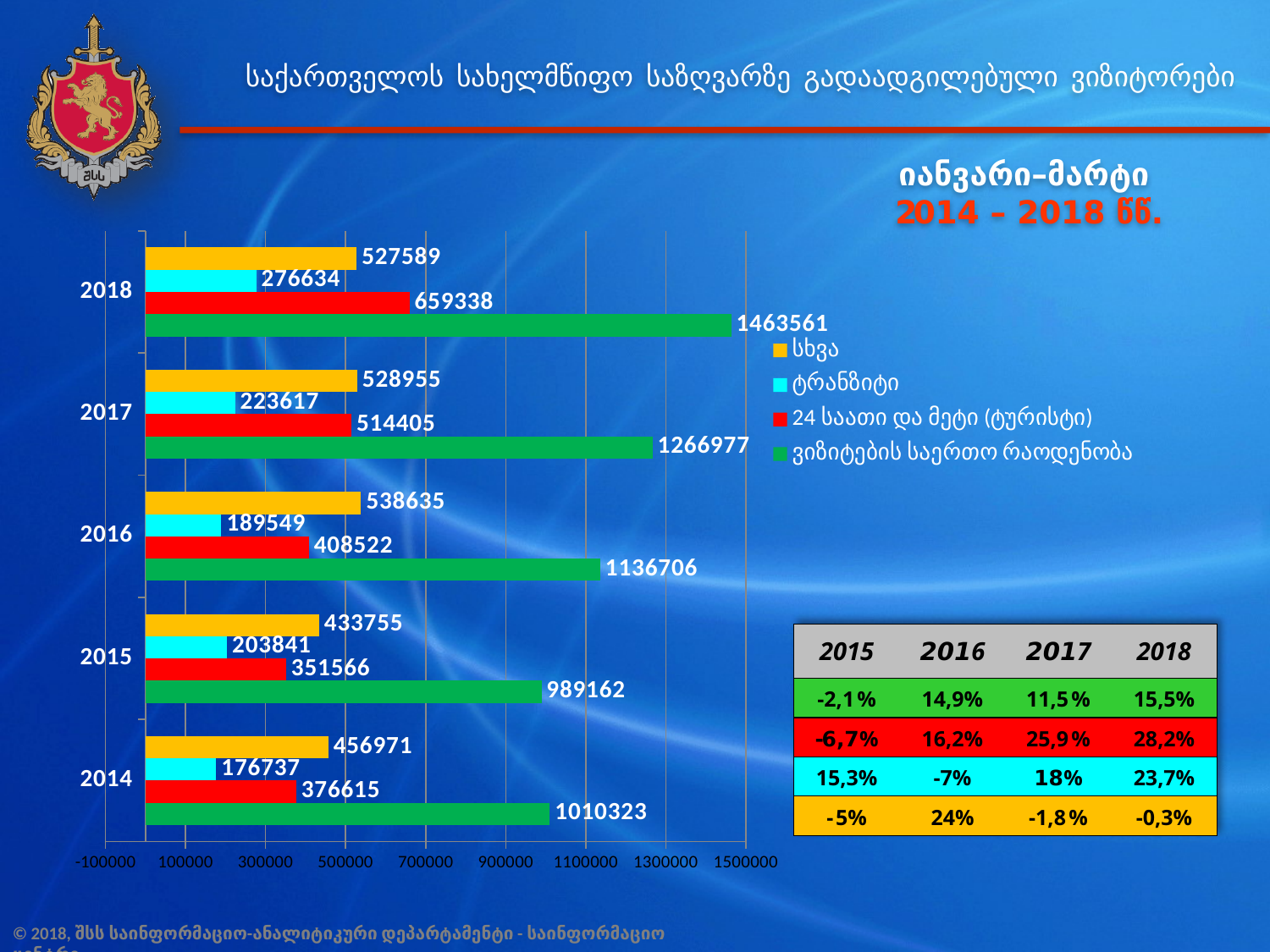
Which year has the highest value for the green series (ვიზიტების საერთო რაოდენობა)? 2018 What is the value of the cyan series (ტრანზიტი) for 2016? 189549 How many series does the chart legend list? 4 What is the value of the red series (24 საათი და მეტი (ტურისტი)) for 2014? 376615 What is the value of the green series (ვიზიტების საერთო რაოდენობა) for 2018? 1463561 Which year has the lowest value for the cyan series (ტრანზიტი)? 2014 How many years are shown on the chart? 5 What is the value of the yellow series (სხვა) for 2015? 433755 What is the difference between the green series values for 2018 and 2017? 196584 Does the red series (24 საათი და მეტი (ტურისტი)) rise or fall from 2015 to 2018? rise What type of chart is shown on the slide? bar chart Which is larger: the red series value for 2017 or the yellow series value for 2017? the yellow series value (528955)